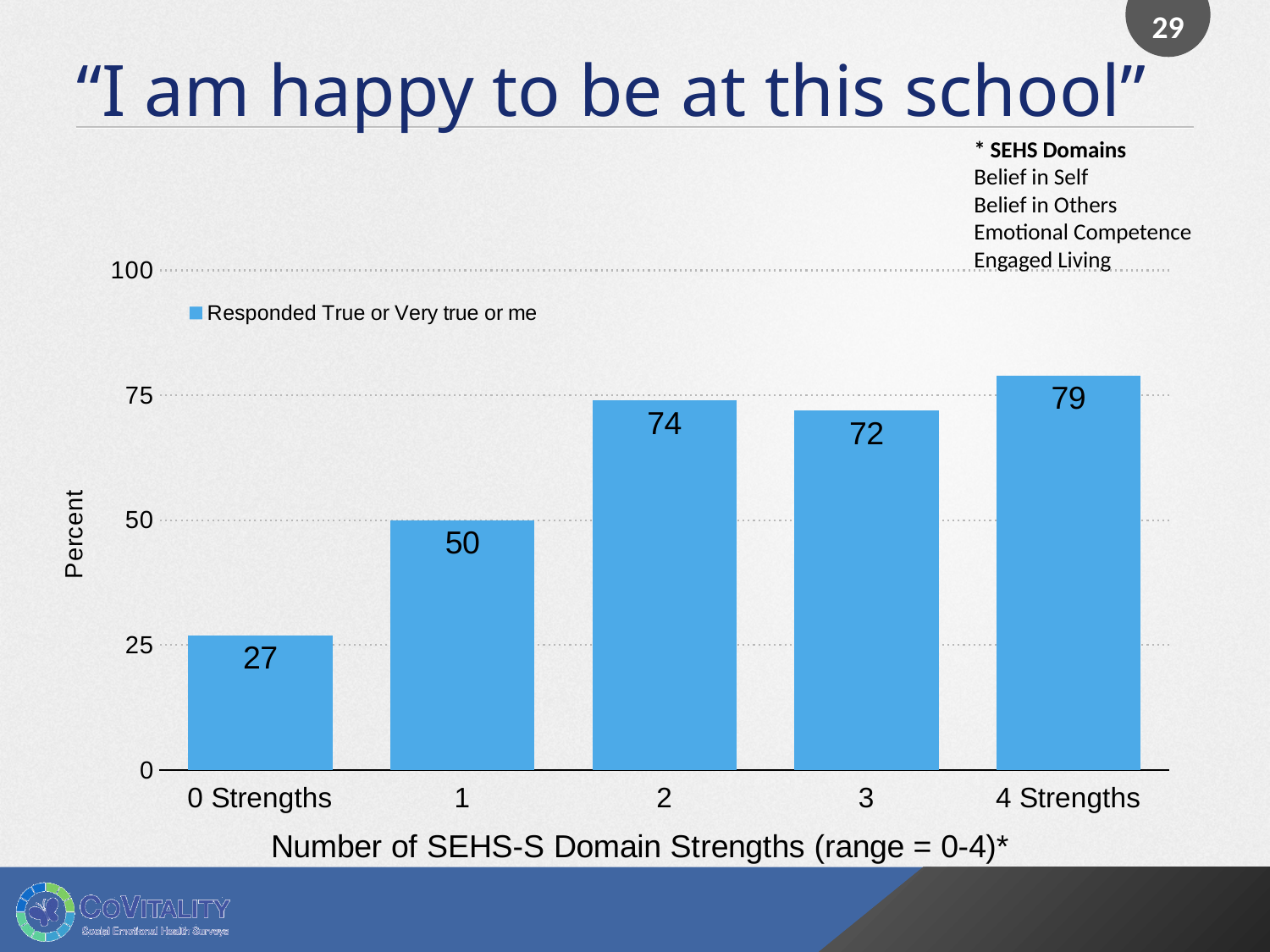
What percent of students with 0 Strengths responded True or Very true? 27 What is the difference between the values for 4 Strengths and 0 Strengths? 52 Which category has the lowest value? 0 Strengths Is the value for 3 strengths greater or less than 75? less What is the value for 4 Strengths? 79 What is the difference between the values for 2 strengths and 3 strengths? 2 What kind of chart is shown on the slide? bar chart What is the value for the 2 strengths category? 74 What is the legend entry for the plotted series? Responded True or Very true or me How many categories are shown on the x axis? 5 Which category has the highest value? 4 Strengths Which is larger, the value for 1 strength or the value for 3 strengths? 3 strengths